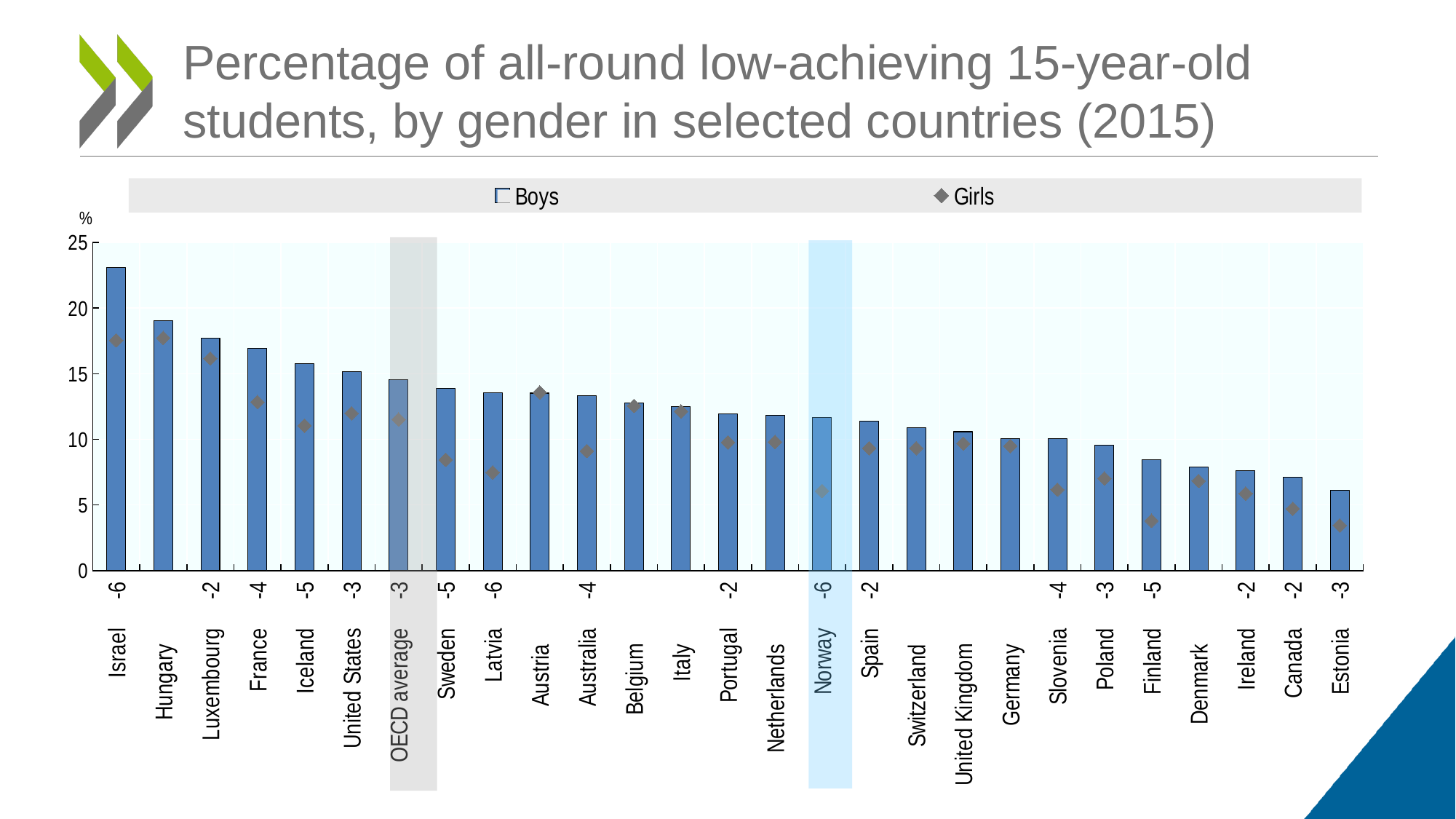
Is the value for boys in Israel greater or less than 20? greater Is the value for girls in Finland greater or less than 5? less Which is larger, the boys' value for Israel or the boys' value for Estonia? Israel In Norway, which is larger, the value for boys or the value for girls? Boys Which country has the lowest percentage of low-achieving boys? Estonia How many countries or groups are shown on the x axis? 27 Is the value for boys in Estonia greater or less than 10? less How many series does the legend list? 2 Do the boys' values rise or fall from left to right along the x axis? fall Which country has the highest percentage of low-achieving boys? Israel